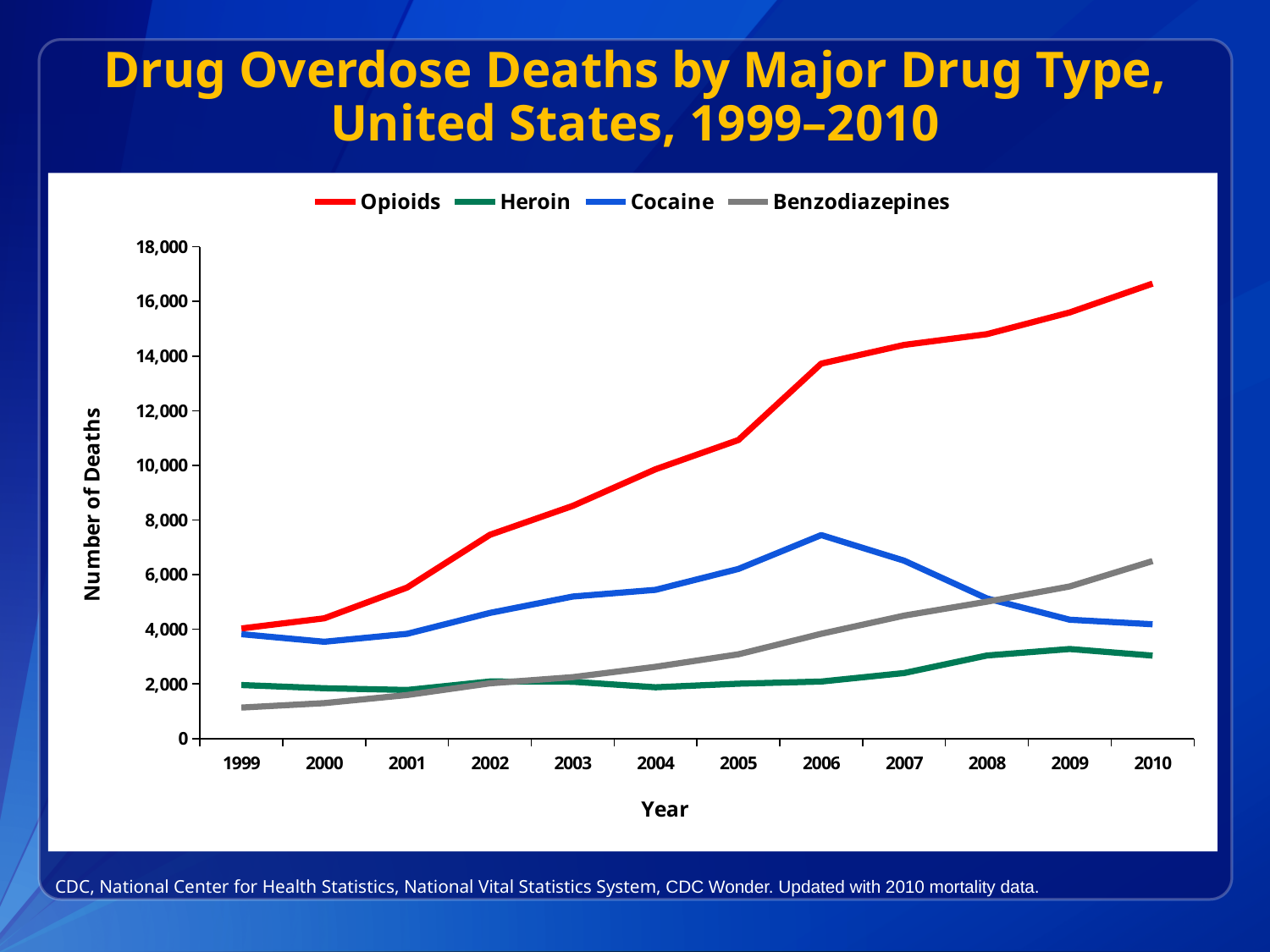
Do Opioid deaths rise or fall from 1999 to 2010? Rise In 2006, which is larger: Cocaine deaths or Heroin deaths? Cocaine Which drug type has the highest number of deaths in 2010? Opioids How many series does the legend list? 4 Which drug type has the lowest number of deaths in 1999? Benzodiazepines What is the title of the chart? Drug Overdose Deaths by Major Drug Type, United States, 1999–2010 Is the value for Benzodiazepines in 1999 greater or less than 2,000? less In 2010, which is larger: Cocaine deaths or Benzodiazepine deaths? Benzodiazepines How many years are plotted along the x axis? 12 What kind of chart is shown on the slide? Line chart Is the value for Opioids in 2010 greater or less than 16,000? greater In which year does the Cocaine line reach its peak? 2006